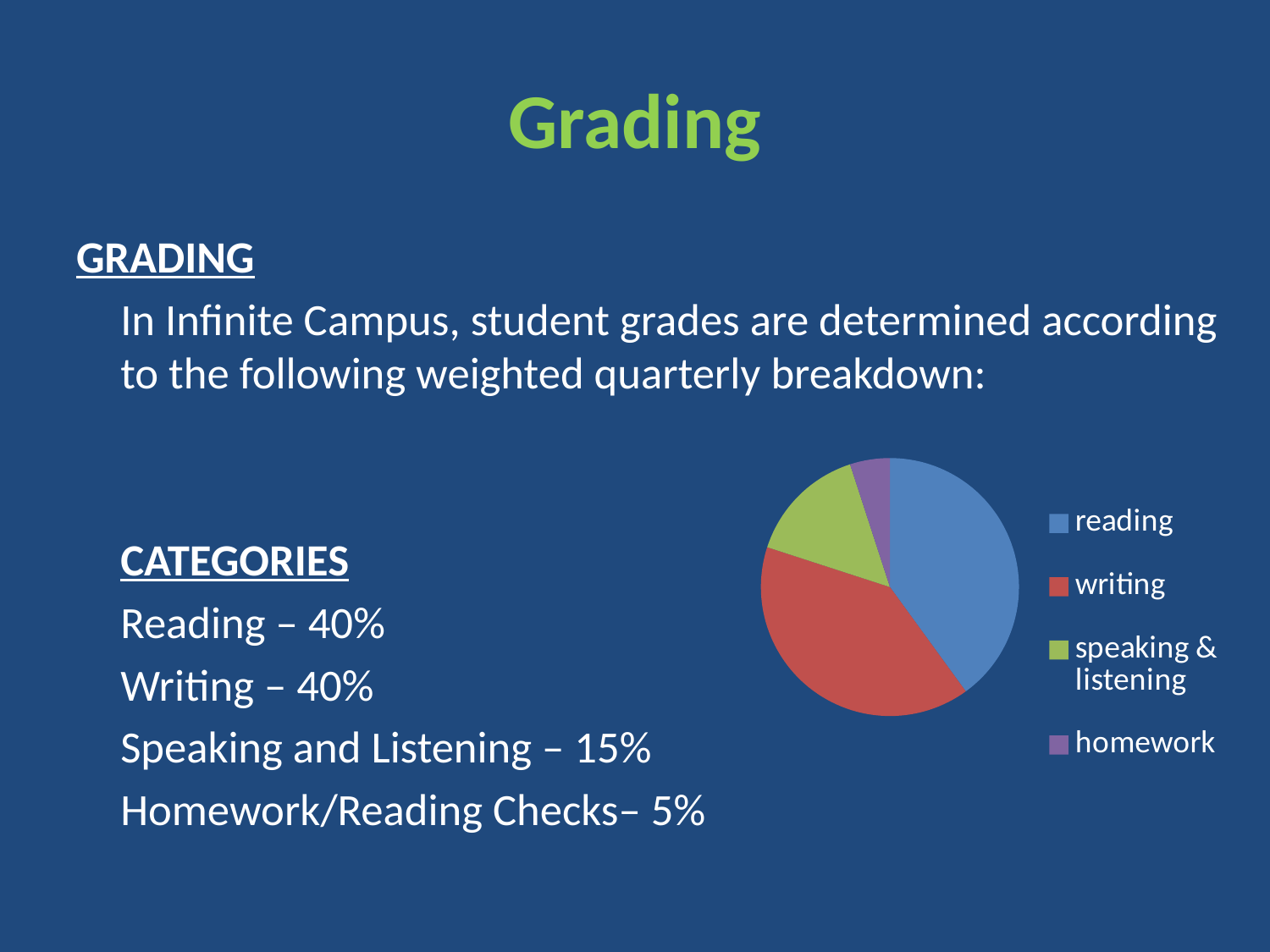
Which slice is larger in the pie chart, speaking & listening or homework? speaking & listening Which legend entry is shown in red? writing How many slices does the pie chart have? 4 What share of the pie does the reading slice represent? 40% What colour is the reading slice in the pie chart? blue What kind of chart is shown on the slide? pie chart What share of the pie does the homework slice represent? 5% What share of the pie does the speaking & listening slice represent? 15% What is the difference in percentage points between the writing slice and the speaking & listening slice? 25 Which slice is larger in the pie chart, writing or speaking & listening? writing Which category has the smallest slice in the pie chart? homework How many entries does the pie chart's legend list? 4